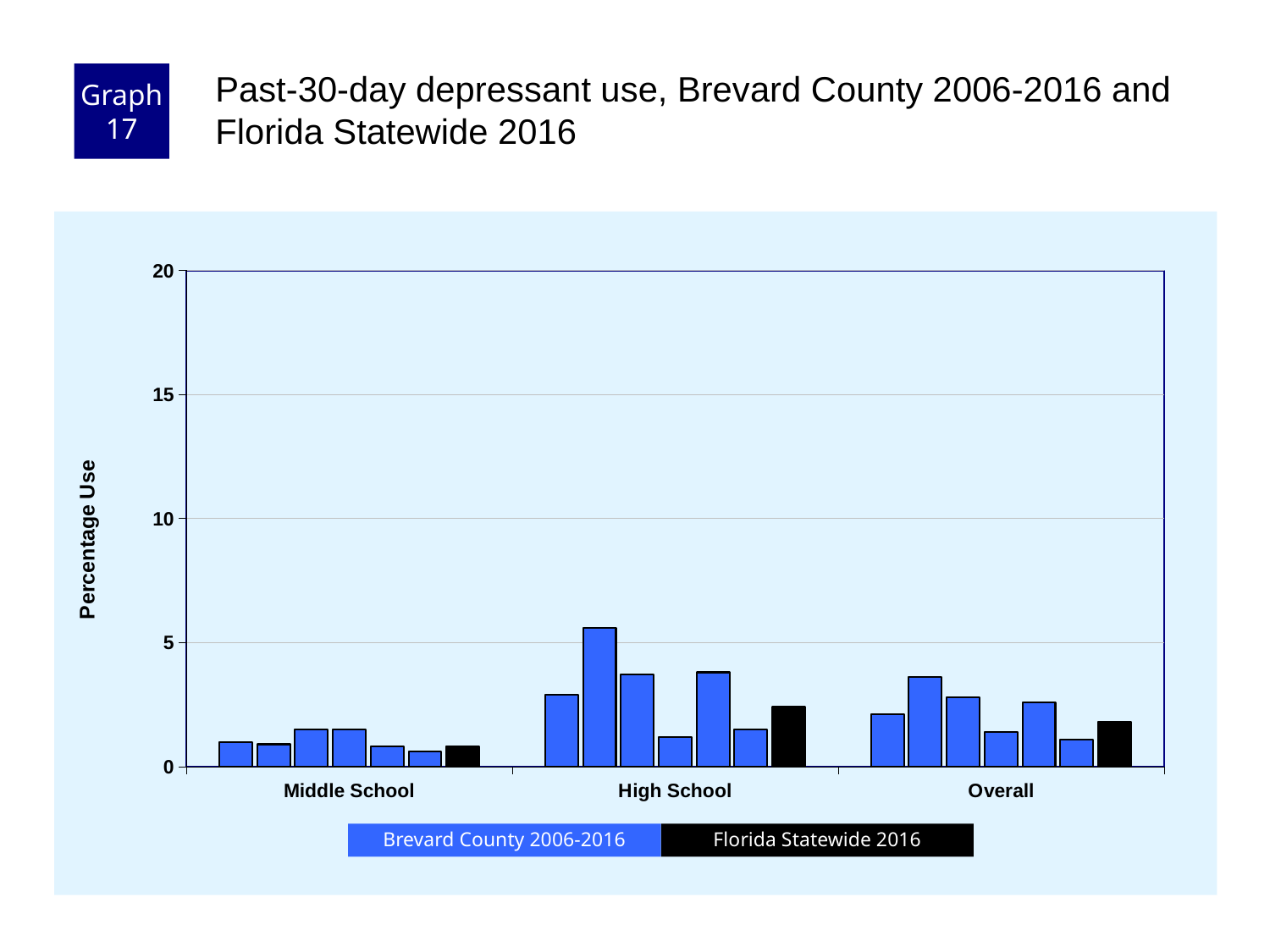
Is the Florida Statewide 2016 value for High School greater or less than 5? less What kind of chart is shown on the slide? bar chart Is the Florida Statewide 2016 value for Middle School greater or less than 5? less How many series does the legend list? 2 Which is larger, the Florida Statewide 2016 value for Overall or for Middle School? Overall How many bars are plotted in the High School group? 7 What colour represents Florida Statewide 2016 in the legend? black What is the label on the y axis? Percentage Use Which is larger, the Florida Statewide 2016 value for High School or for Middle School? High School How many categories are shown along the x axis? 3 Which x-axis group contains the tallest bar on the chart? High School Is the tallest bar in the High School group greater or less than 5? greater